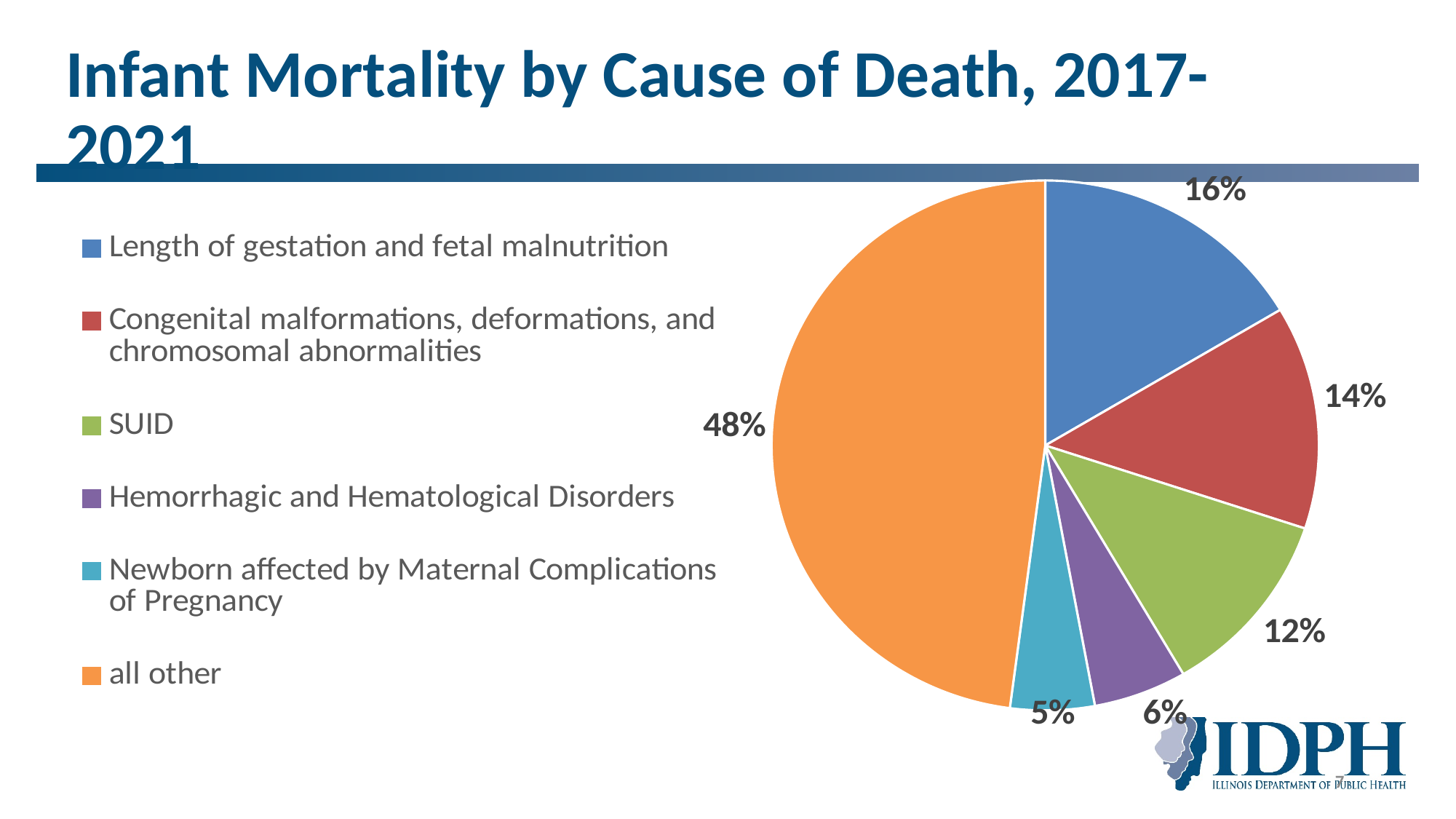
What type of chart is shown on the slide? Pie chart What share of infant deaths is attributed to Length of gestation and fetal malnutrition? 16% What percentage of the pie is SUID? 12% What share is shown for Congenital malformations, deformations, and chromosomal abnormalities? 14% What is the difference in percentage points between the all other slice and the SUID slice? 36 What percentage is shown for Newborn affected by Maternal Complications of Pregnancy? 5% Which category has the smallest slice of the pie? Newborn affected by Maternal Complications of Pregnancy What colour is the slice for all other? Orange Which is larger: the share for Length of gestation and fetal malnutrition or the share for SUID? Length of gestation and fetal malnutrition How many categories does the pie chart show? 6 What share of the pie is Hemorrhagic and Hematological Disorders? 6% Which category has the largest slice of the pie? all other